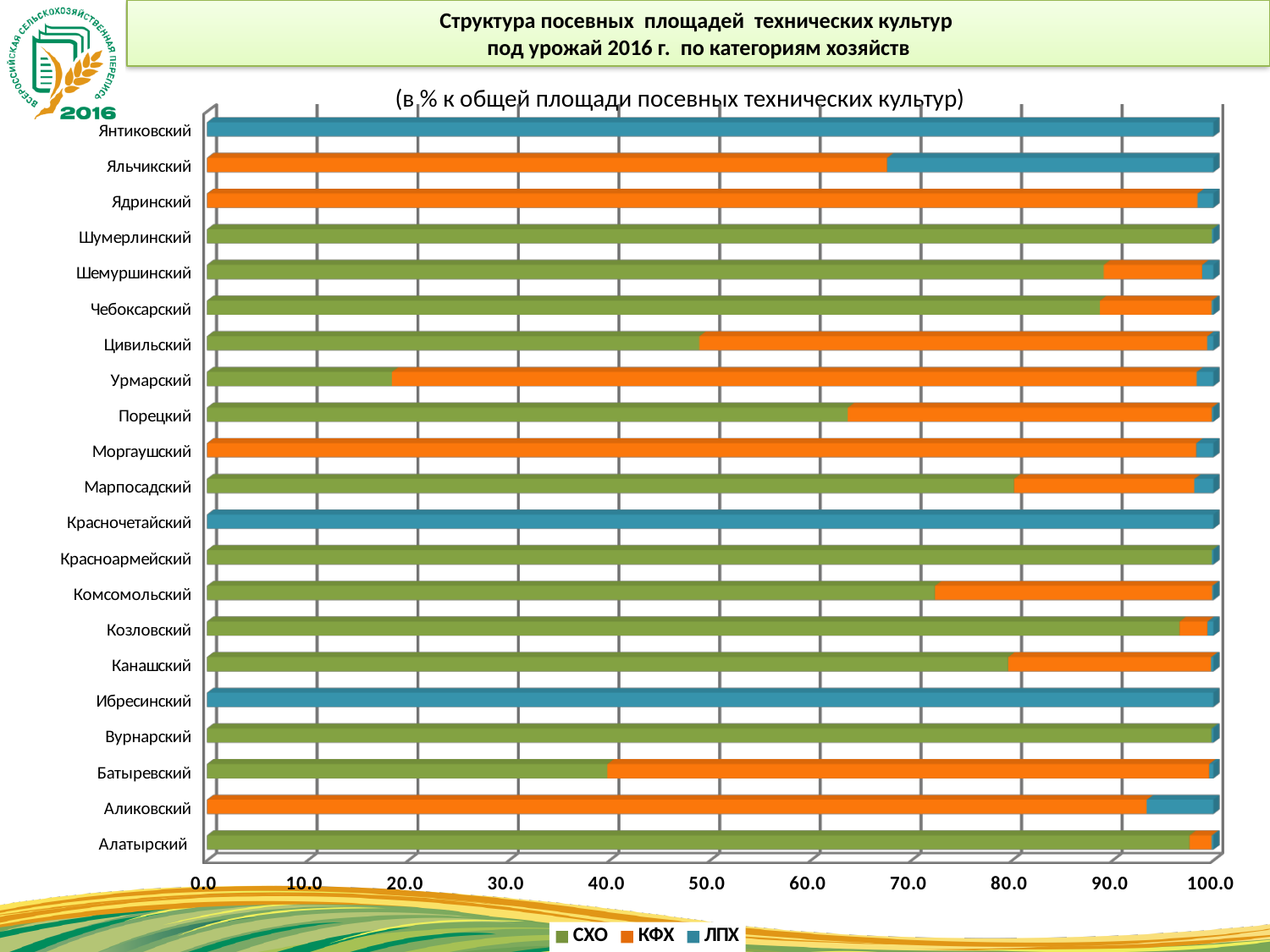
Which series makes up the entire bar for Красночетайский? ЛПХ Is the СХО value for Козловский greater or less than 90.0? greater Is the СХО value for Урмарский greater or less than 20.0? less How many districts (categories) are plotted on the chart? 21 Is the КФХ value for Аликовский greater or less than 90.0? greater Which has the larger СХО value, Урмарский or Порецкий? Порецкий How many series does the legend list? 3 What kind of chart is shown on the slide? bar chart What are the three series named in the legend? СХО, КФХ, ЛПХ